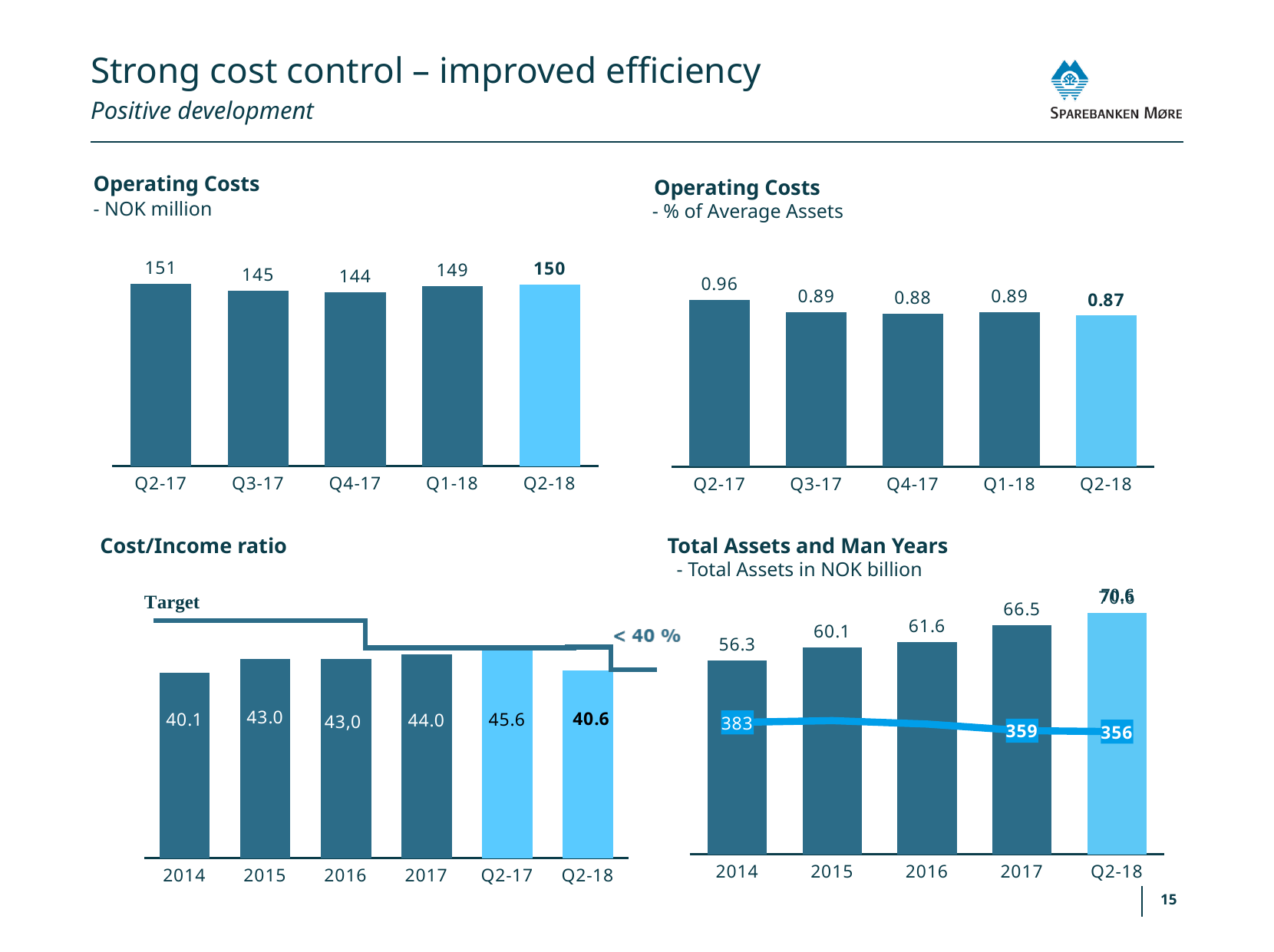
In the Total Assets and Man Years chart, what is the total assets value for 2017? 66.5 In the Total Assets and Man Years chart, do the total assets values rise or fall from 2014 to Q2-18? rise In the Cost/Income ratio chart, which is larger, the value for Q2-17 or the value for Q2-18? Q2-17 In the Operating Costs - % of Average Assets chart, what is the value for Q2-18? 0.87 In the Operating Costs - NOK million chart, which quarter has the lowest value? Q4-17 In the Total Assets and Man Years chart, what is the man years value for Q2-18? 356 In the Operating Costs - NOK million chart, what is the difference between Q2-17 and Q4-17? 7 In the Operating Costs - NOK million chart, what is the value for Q2-17? 151 In the Cost/Income ratio chart, what is the value for Q2-18? 40.6 In the Operating Costs - % of Average Assets chart, which quarter has the highest value? Q2-17 In the Cost/Income ratio chart, what is the difference between the Q2-17 value and the Q2-18 value? 5.0 In the Operating Costs - NOK million chart, how many quarters are shown? 5